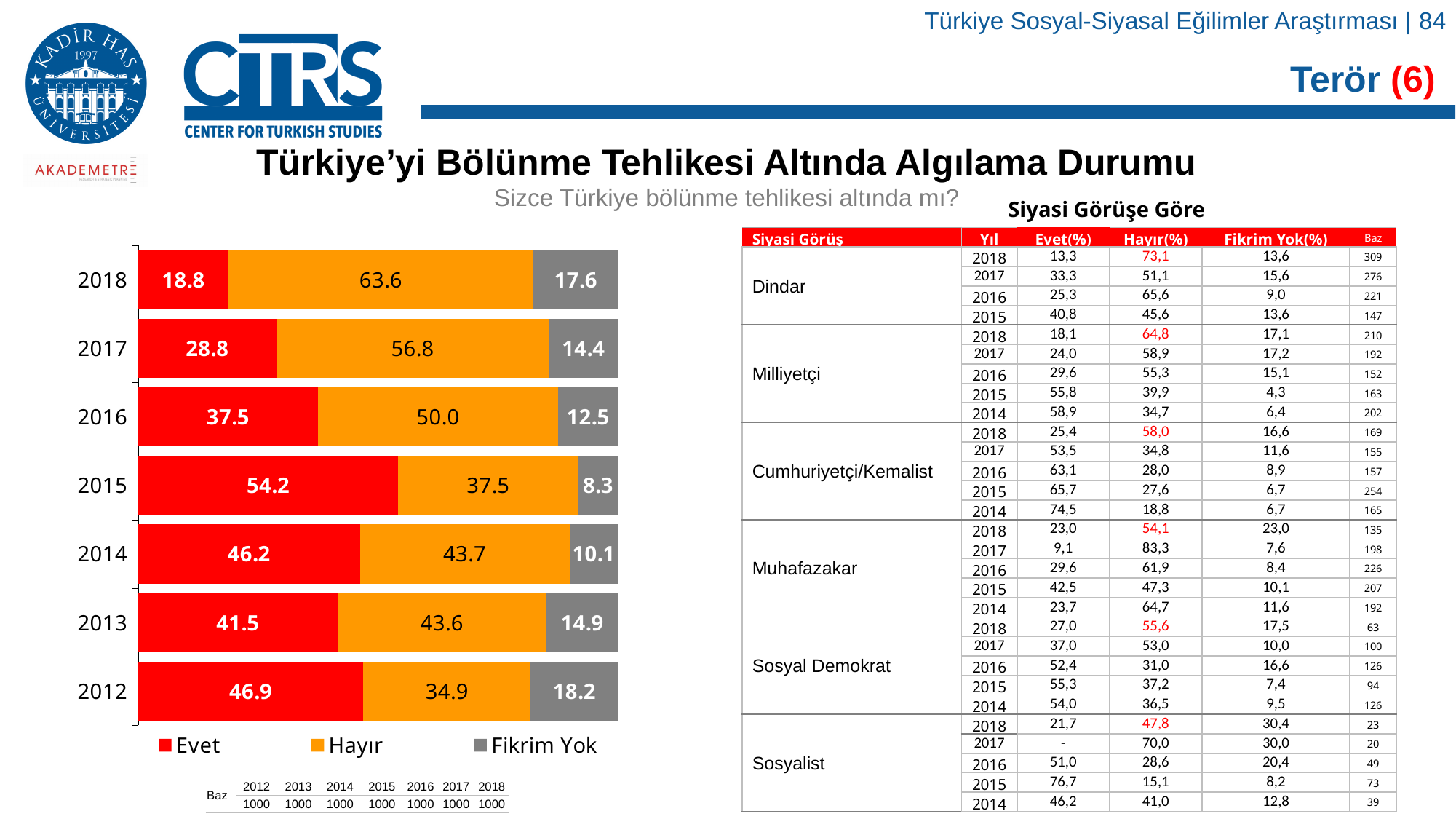
What is the Evet value for 2018 in the bar chart? 18.8 How many years are shown in the bar chart? 7 What is the difference between the Evet values for 2015 and 2018 in the bar chart? 35.4 What is the Fikrim Yok value for 2012 in the bar chart? 18.2 What is the Hayır value for 2015 in the bar chart? 37.5 Which is larger in the bar chart: the Evet value for 2014 or the Hayır value for 2014? Evet (46.2) What type of chart is shown on the left of the slide? Stacked bar chart In which year is the Evet value lowest in the bar chart? 2018 In which year is the Hayır value highest in the bar chart? 2018 Which colour represents Hayır in the bar chart? Orange How many series does the legend of the bar chart list? 3 In which year is the Fikrim Yok value lowest in the bar chart? 2015